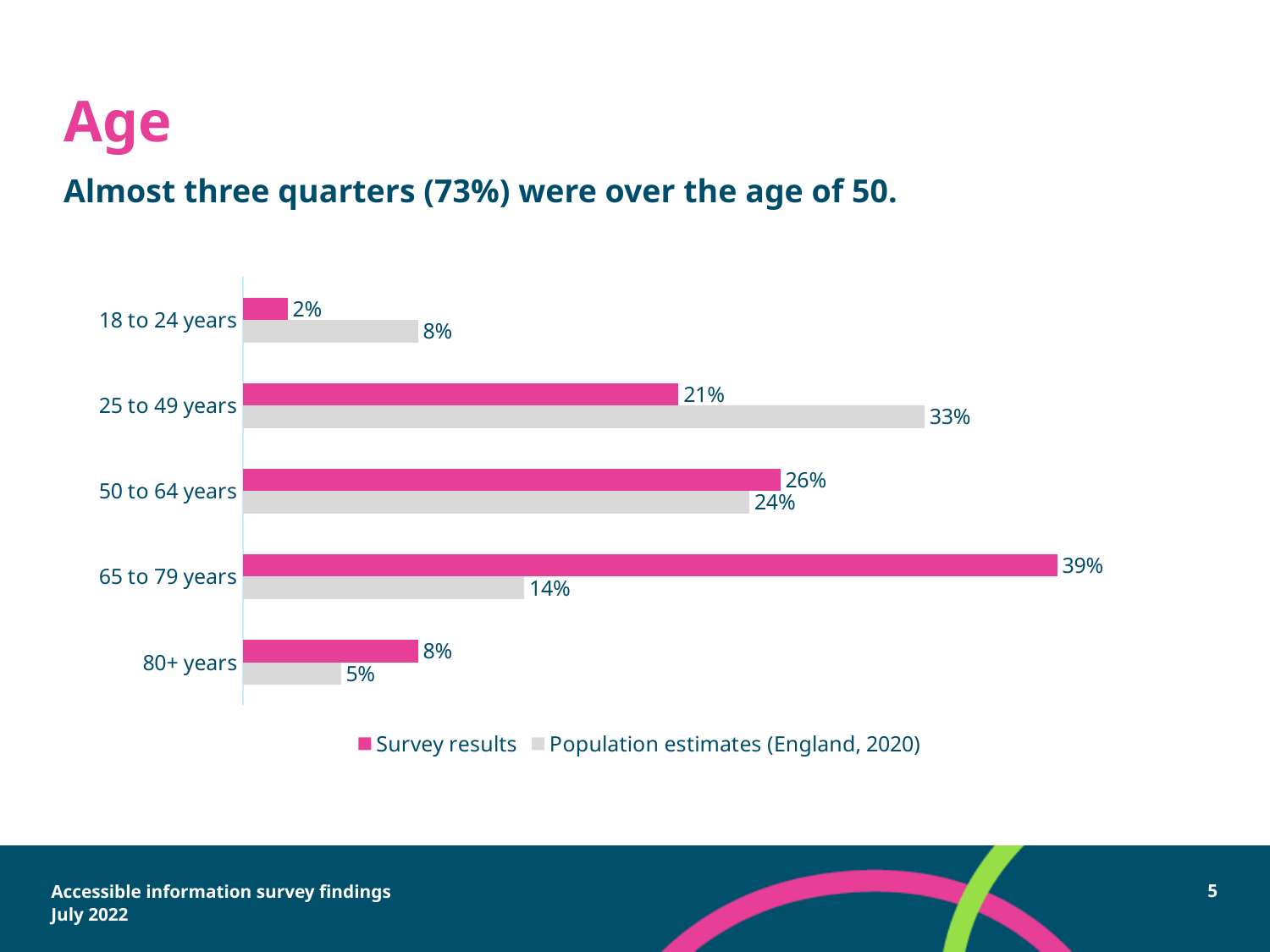
What is the difference between the survey result and the population estimate for the 18 to 24 years age group? 6% How many series does the legend list? 2 For the 25 to 49 years age group, which is larger: the survey result or the population estimate? Population estimate (England, 2020) What kind of chart is shown on the slide? Bar chart Which age group has the highest survey result? 65 to 79 years How many age groups are shown on the chart? 5 Which age group has the lowest population estimate (England, 2020)? 80+ years What is the survey result for the 65 to 79 years age group? 39% What is the population estimate (England, 2020) for the 25 to 49 years age group? 33% What is the survey result for the 18 to 24 years age group? 2% What is the difference between the survey result and the population estimate for the 65 to 79 years age group? 25% Which colour represents the Survey results series in the chart? Pink